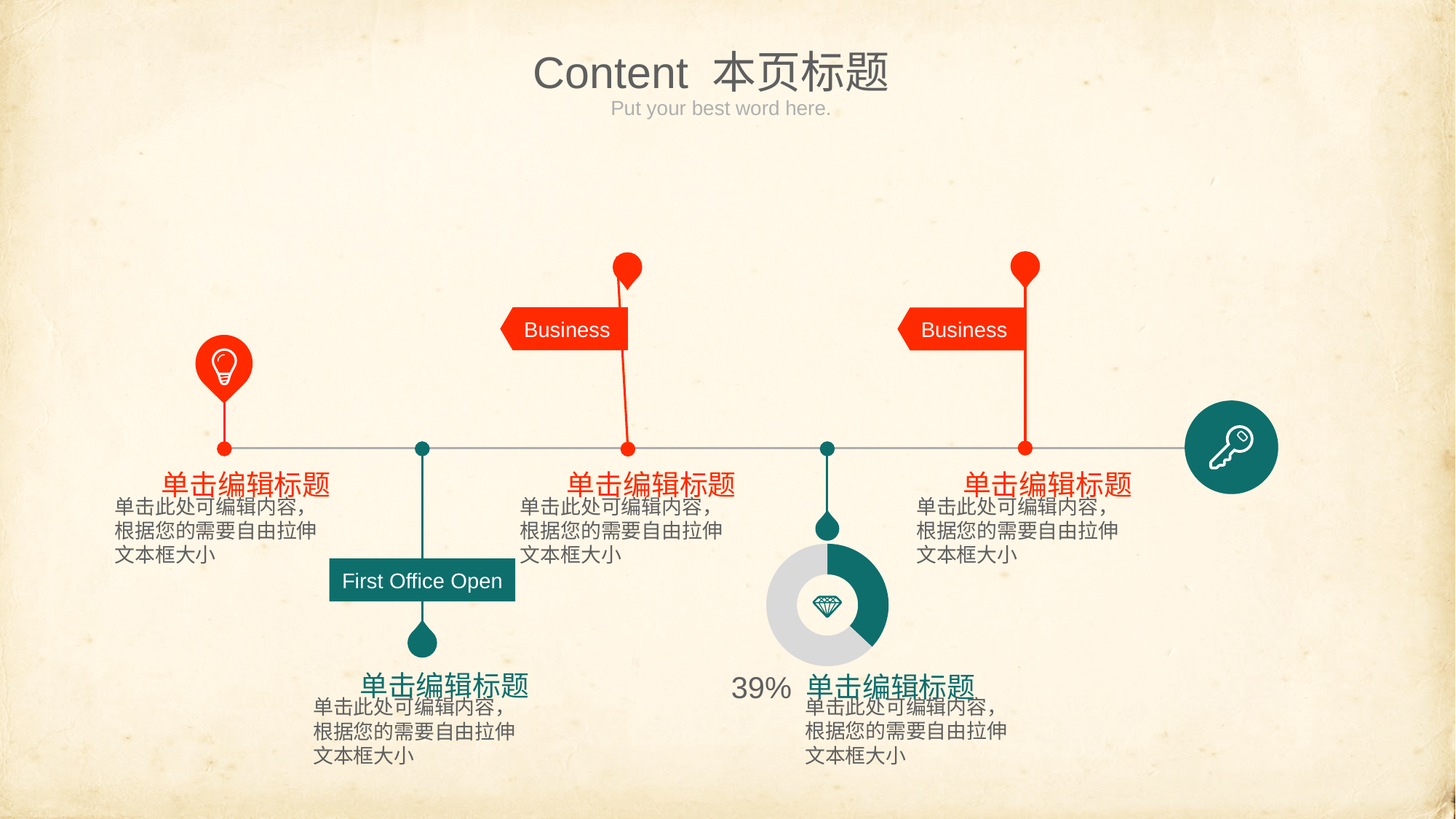
How many slices does the donut chart have? 2 What icon appears in the centre of the donut chart? A diamond Is the teal slice of the donut chart greater or less than 50%? less In the donut chart, which slice is larger, the teal one or the grey one? The grey one What kind of chart is shown on the timeline near the bottom centre of the slide? Donut chart What percentage is labelled next to the donut chart? 39% Which slice of the donut chart is the smallest? The teal slice